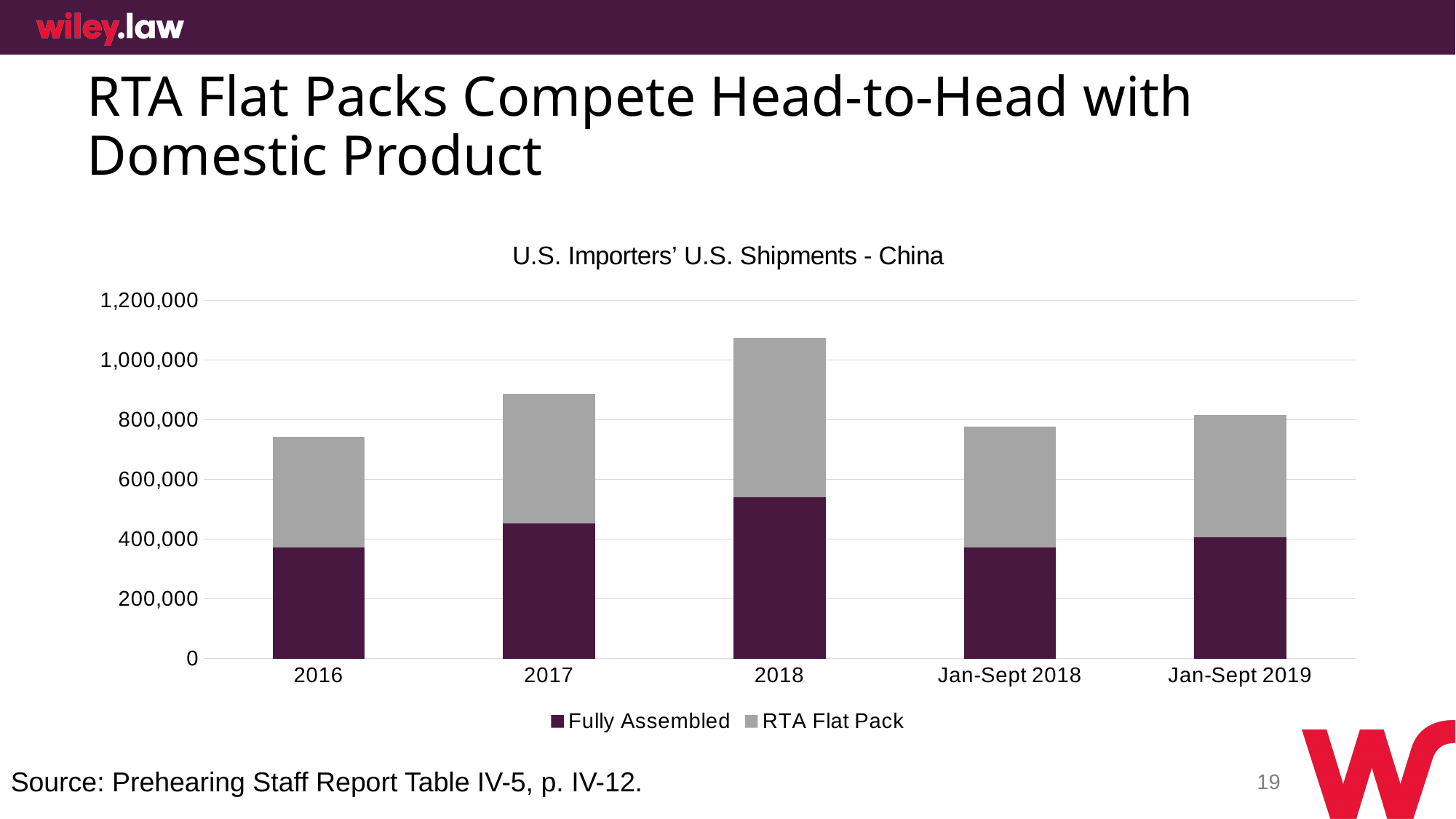
Which series is shown in grey in the legend? RTA Flat Pack What kind of chart is shown on the slide? Stacked bar chart Which category has the highest total bar? 2018 Is the Fully Assembled value for 2018 greater or less than 400,000? greater Is the total bar for 2018 greater or less than 1,000,000? greater Do the total bars rise or fall from 2016 to 2018? rise How many categories are shown on the x axis? 5 How many series does the legend list? 2 What is the title of the chart? U.S. Importers' U.S. Shipments - China Which category has the largest Fully Assembled segment? 2018 Which total bar is taller, 2017 or Jan-Sept 2019? 2017 Is the total bar for 2016 greater or less than 800,000? less